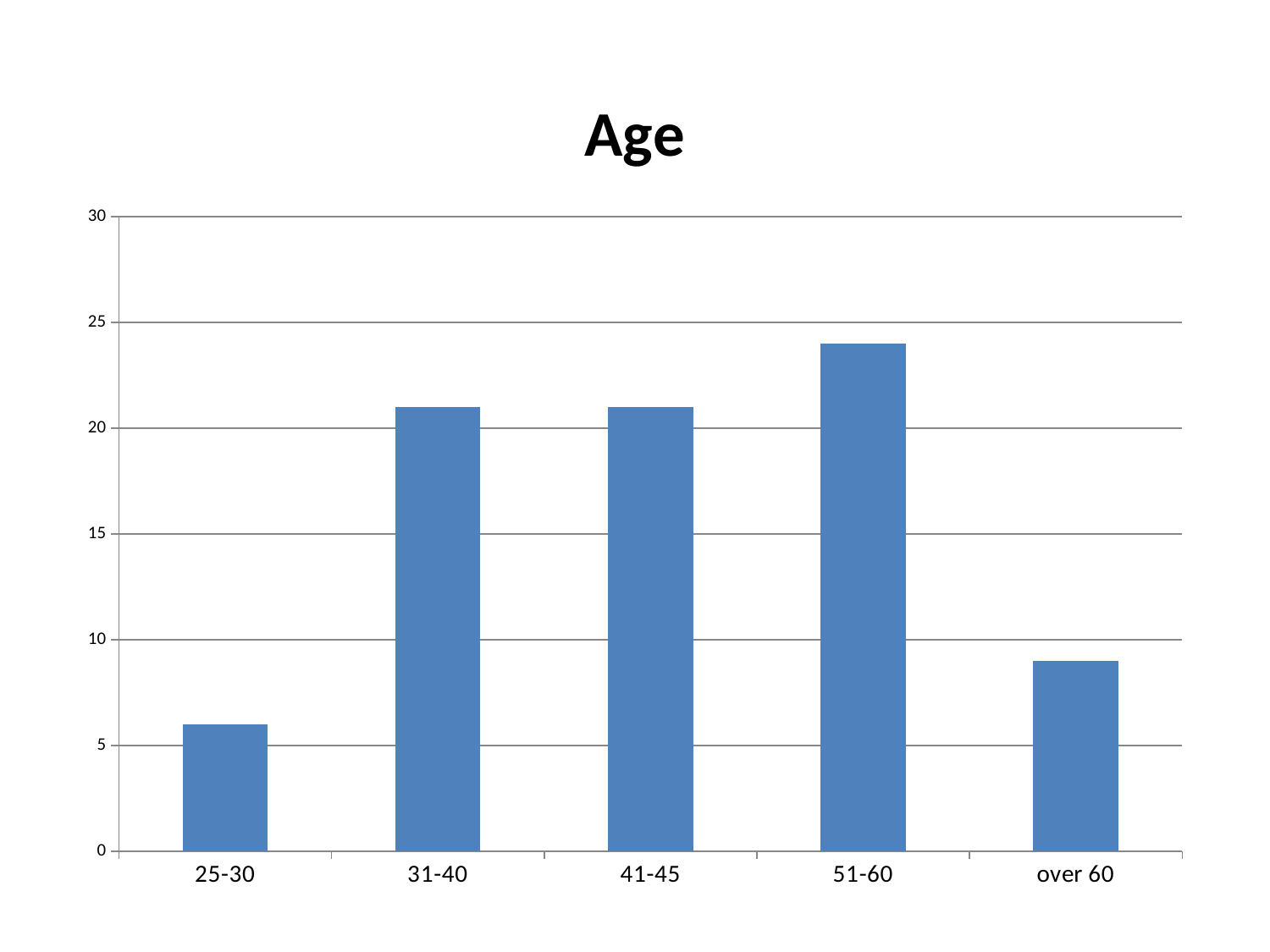
Is the value for 51-60 greater or less than 25? less What is the title of the chart? Age Which is larger, the value for 25-30 or the value for 41-45? 41-45 Is the value for 51-60 greater or less than 20? greater Which age category has the lowest value? 25-30 Is the value for over 60 greater or less than 10? less What type of chart is shown on the slide? bar chart Which age category has the highest value? 51-60 Which is larger, the value for 51-60 or the value for over 60? 51-60 How many age categories are shown on the x axis? 5